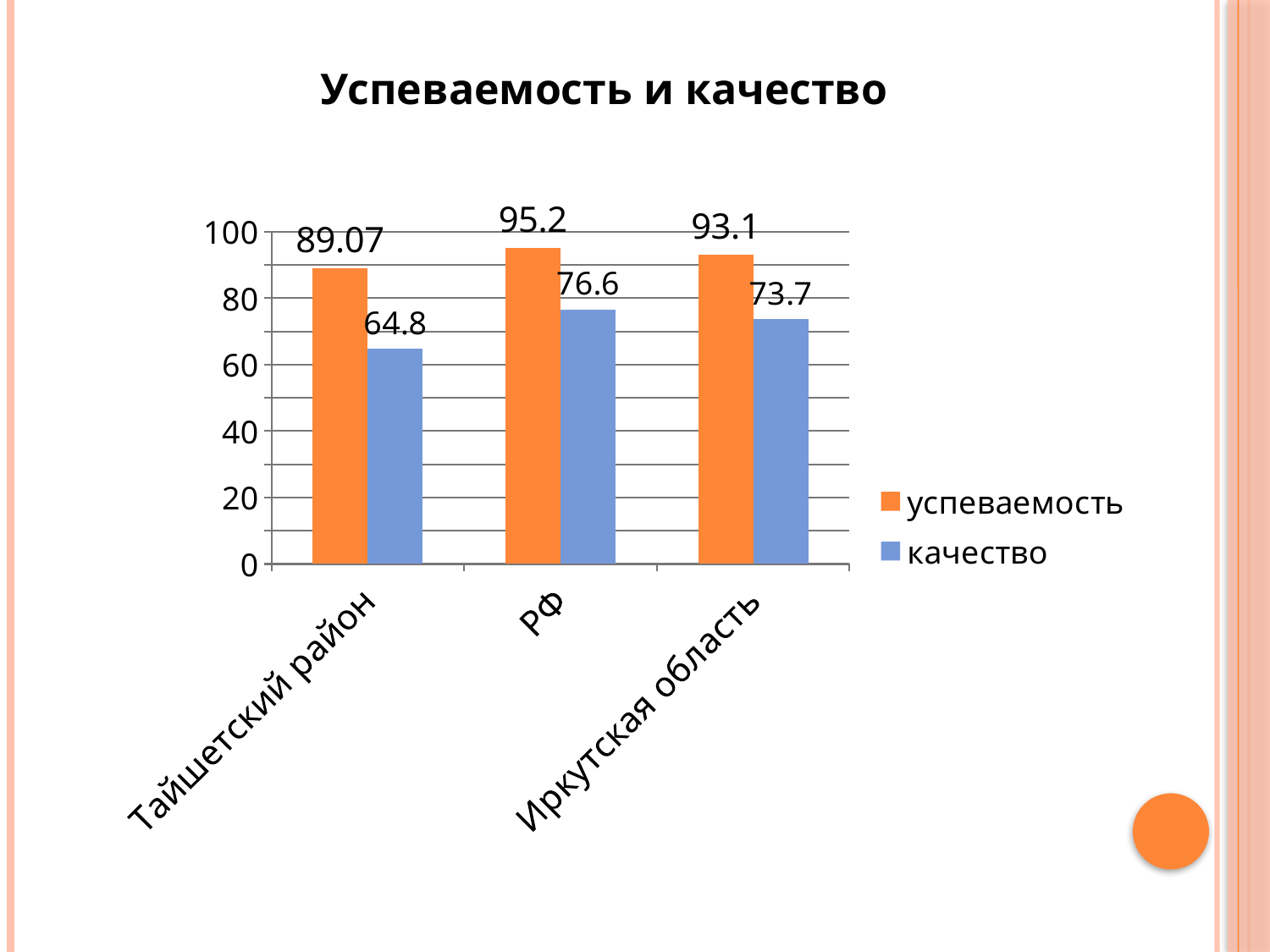
Is the качество value for Тайшетский район greater or less than 80? less What is the difference between the успеваемость and качество values for Иркутская область? 19.4 What is the качество value for Иркутская область? 73.7 What is the качество value for РФ? 76.6 Which category has the highest успеваемость value? РФ What is the успеваемость value for Тайшетский район? 89.07 How many categories are shown on the x axis? 3 What colour are the bars for the качество series? blue Which is larger: the качество value for РФ or for Иркутская область? РФ Which category has the lowest качество value? Тайшетский район How many series does the legend list? 2 What kind of chart is shown on the slide? bar chart